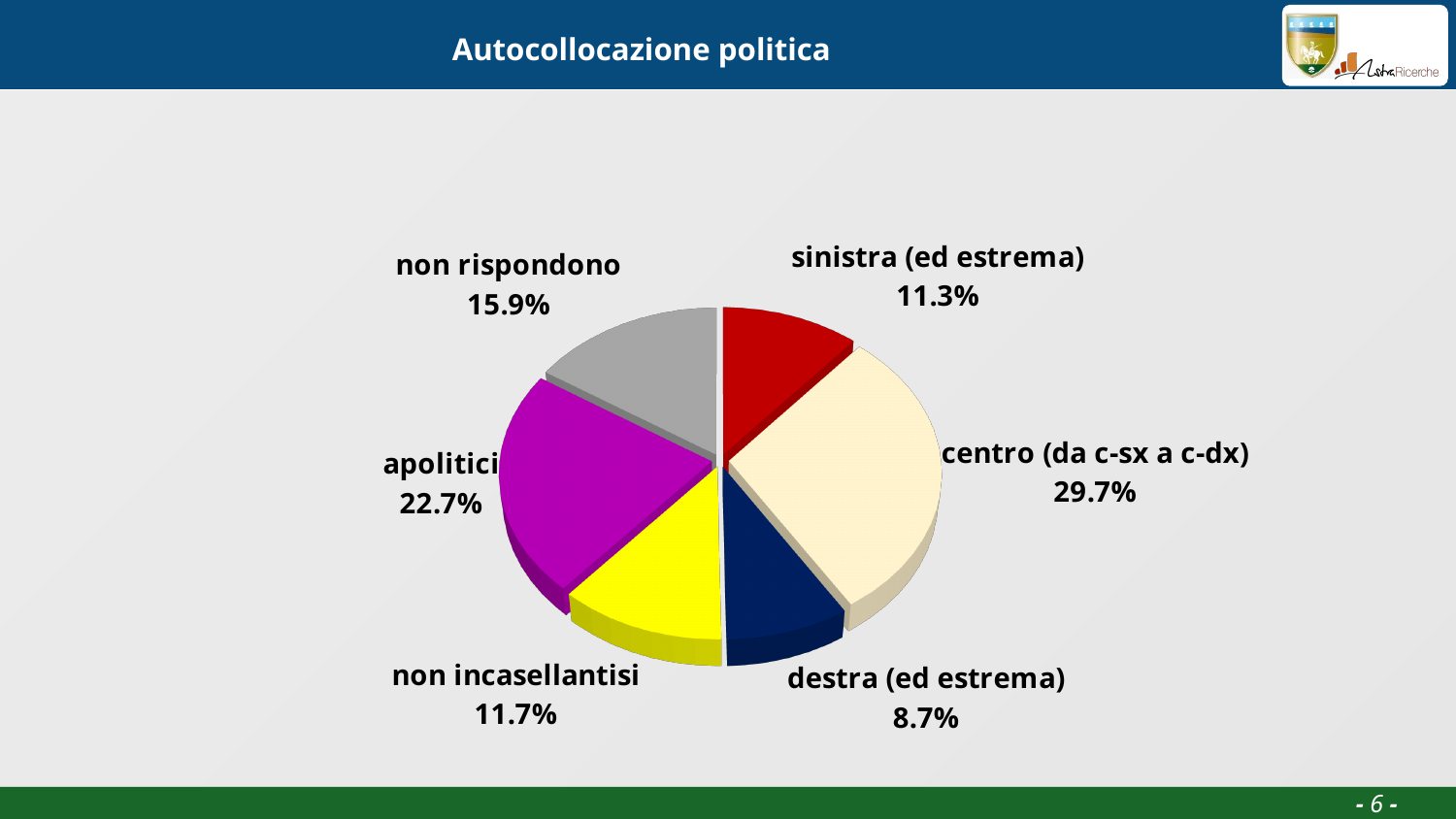
What colour is the slice for 'apolitici'? purple What is the title of the chart? Autocollocazione politica What percentage is shown for 'non rispondono'? 15.9% How many slices does the pie chart have? 6 What kind of chart is shown on the slide? pie chart What is the difference between the shares of 'centro (da c-sx a c-dx)' and 'apolitici'? 7.0% What percentage is shown for 'destra (ed estrema)'? 8.7% What percentage is shown for 'centro (da c-sx a c-dx)'? 29.7% Which is larger, the share for 'sinistra (ed estrema)' or the share for 'non incasellantisi'? non incasellantisi Which category has the largest share of the pie? centro (da c-sx a c-dx) Which category has the smallest share of the pie? destra (ed estrema) What percentage is shown for 'apolitici'? 22.7%